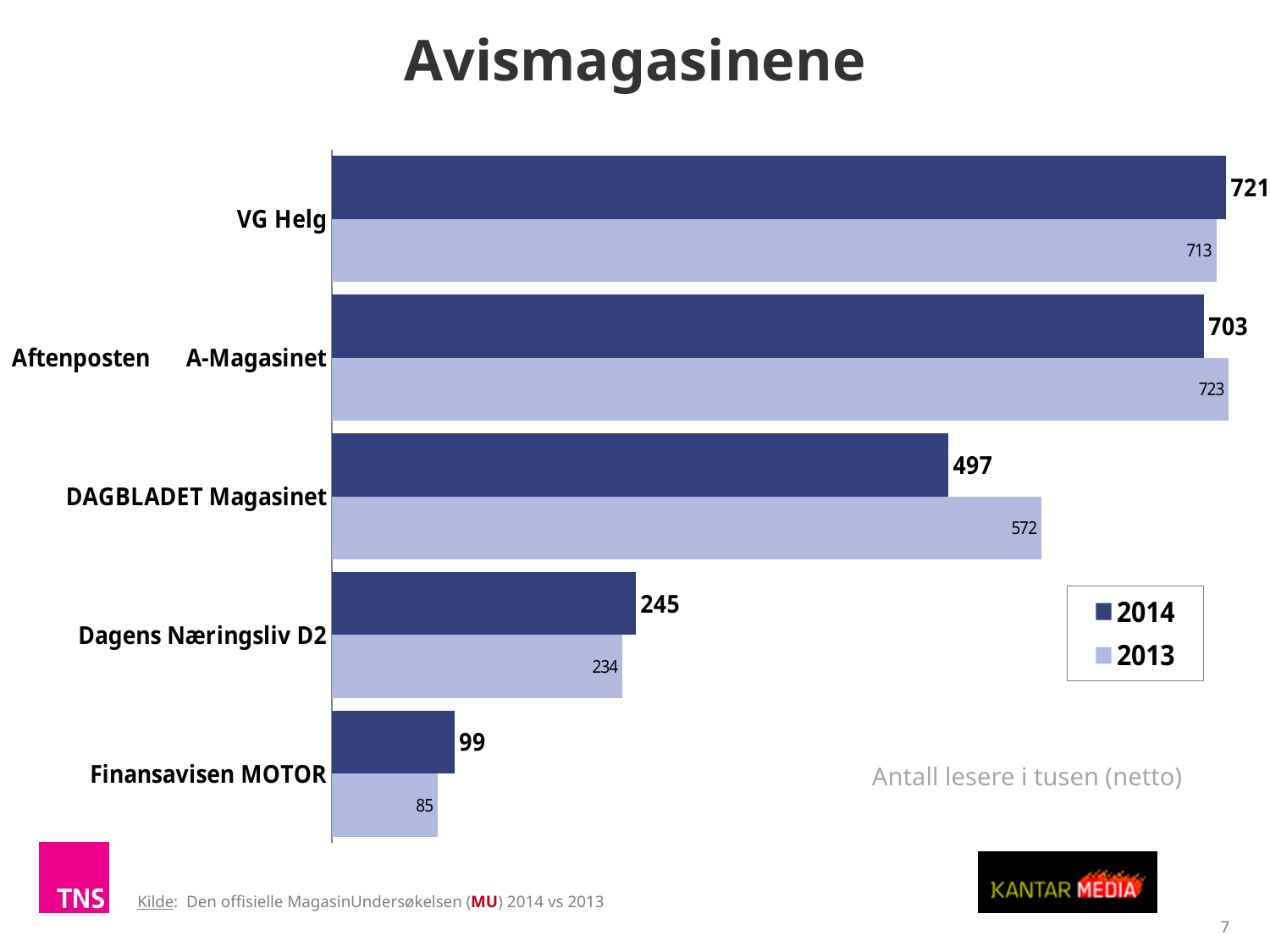
What is the 2014 value for VG Helg? 721 What is the difference between the 2013 and 2014 values for DAGBLADET Magasinet? 75 What is the title of the chart? Avismagasinene How many categories are shown in the chart? 5 What kind of chart is shown on the slide? Bar chart Which category has the highest 2014 value? VG Helg What is the 2014 value for Finansavisen MOTOR? 99 Which is larger for Dagens Næringsliv D2, the 2014 value or the 2013 value? 2014 Which category has the lowest 2013 value? Finansavisen MOTOR What is the 2013 value for DAGBLADET Magasinet? 572 How many series does the legend list? 2 Which is larger for Aftenposten A-Magasinet, the 2014 value or the 2013 value? 2013